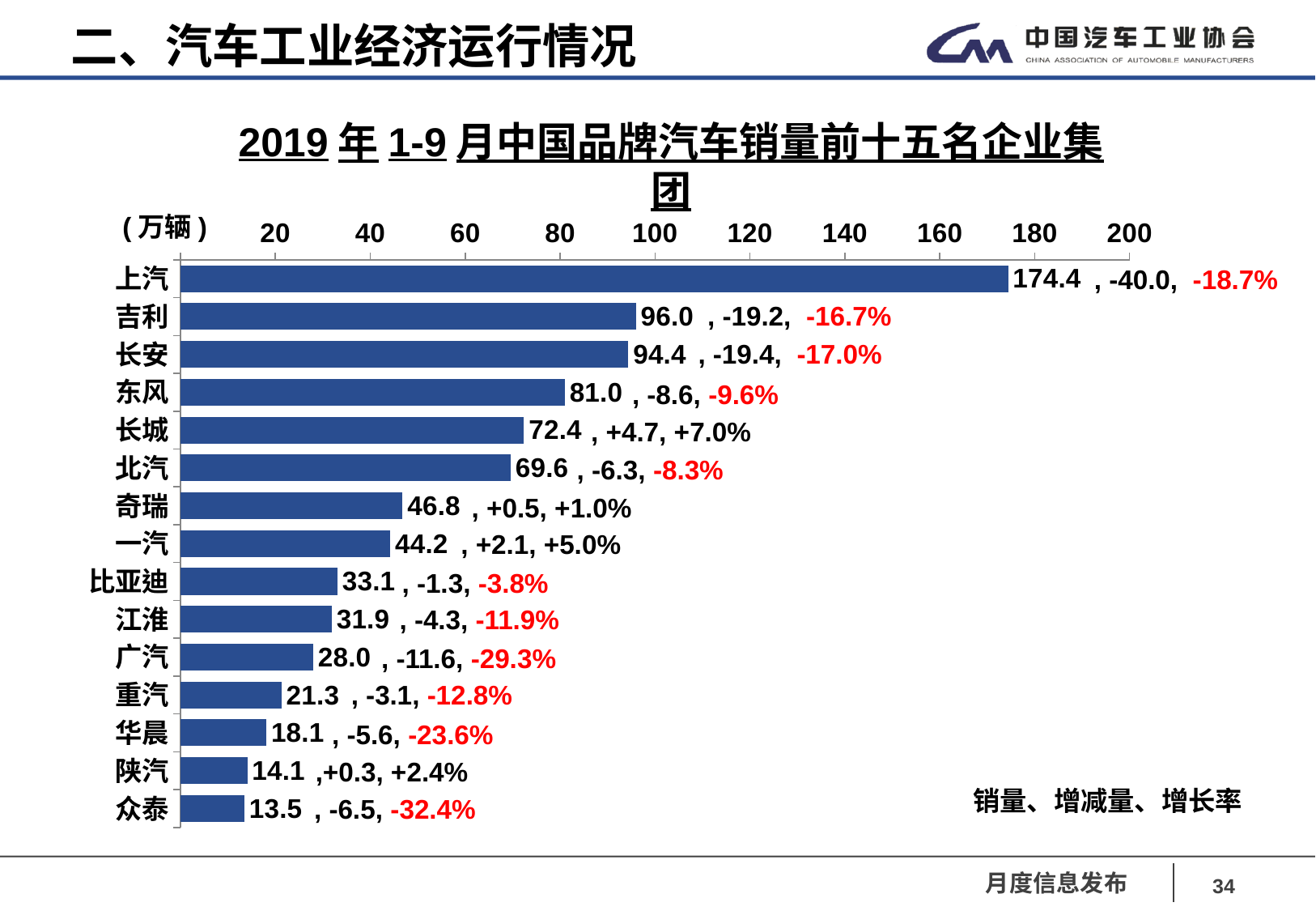
What is the sales volume (万辆) shown for 比亚迪? 33.1 What unit is shown for the chart's axis? 万辆 What is the difference in sales volume (万辆) between 吉利 and 长安? 1.6 Is the sales volume for 奇瑞 greater or less than 40 万辆? greater What kind of chart is shown on the slide? bar chart Which company has the highest sales volume in the chart? 上汽 Which company has the lowest sales volume in the chart? 众泰 Which has the larger sales volume, 东风 or 北汽? 东风 What growth rate is shown for 众泰? -32.4% What is the sales volume (万辆) shown for 上汽? 174.4 What growth rate is shown for 长城? +7.0% How many companies are shown in the chart? 15